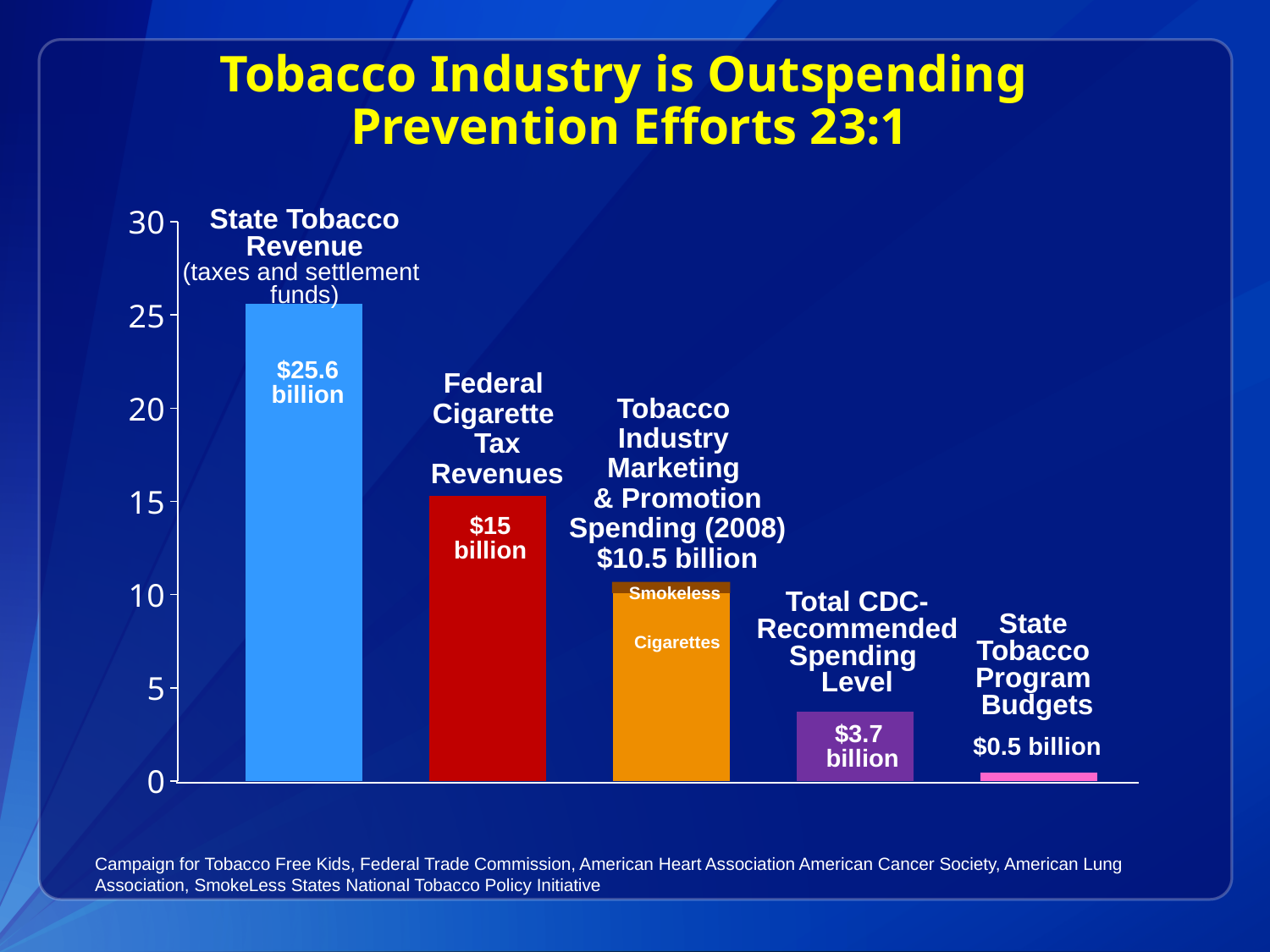
What is the value for the Total CDC-Recommended Spending Level? $3.7 billion What is the value for Tobacco Industry Marketing & Promotion Spending (2008)? $10.5 billion What is the value for Federal Cigarette Tax Revenues? $15 billion What is the difference between the Total CDC-Recommended Spending Level and State Tobacco Program Budgets? $3.2 billion What kind of chart is shown on the slide? Bar chart What is the value for State Tobacco Revenue? $25.6 billion What is the value for State Tobacco Program Budgets? $0.5 billion Which category has the lowest value? State Tobacco Program Budgets Which category has the highest value? State Tobacco Revenue How many bars are shown in the chart? 5 What is the difference between State Tobacco Revenue and Federal Cigarette Tax Revenues? $10.6 billion Which is larger, Federal Cigarette Tax Revenues or Tobacco Industry Marketing & Promotion Spending (2008)? Federal Cigarette Tax Revenues